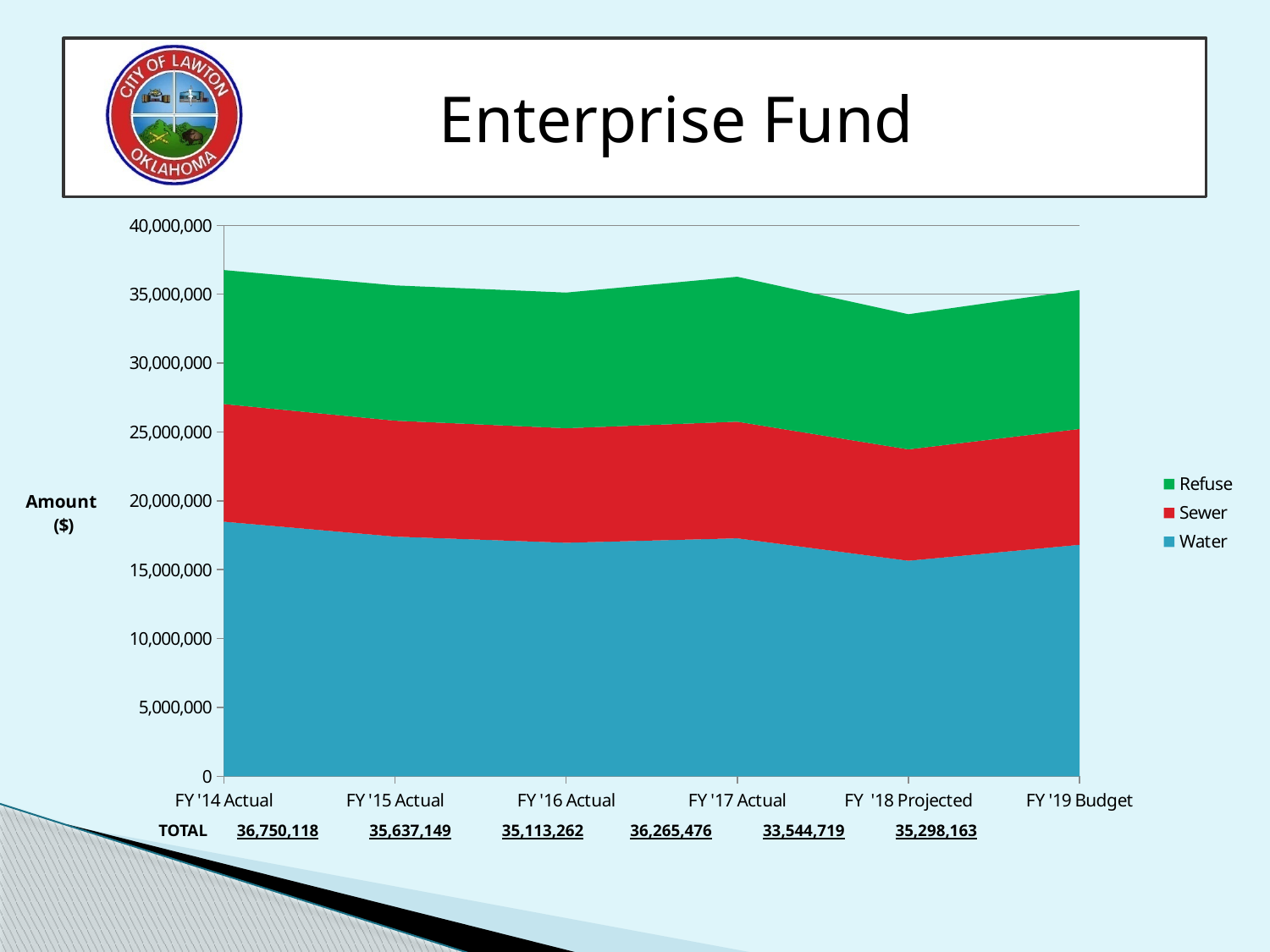
What kind of chart is shown on the slide? Stacked area chart What is the TOTAL shown for FY '14 Actual? 36,750,118 What is the difference between the TOTAL for FY '14 Actual and the TOTAL for FY '18 Projected? 3,205,399 What is the TOTAL shown for FY '18 Projected? 33,544,719 Which is larger, the TOTAL for FY '16 Actual or the TOTAL for FY '17 Actual? FY '17 Actual How many series does the legend list? 3 Do the TOTAL values rise or fall from FY '14 Actual to FY '16 Actual? Fall What is the TOTAL shown for FY '19 Budget? 35,298,163 Is the Water value for FY '14 Actual greater or less than 15,000,000? greater Which fiscal year has the highest TOTAL? FY '14 Actual How many fiscal year categories are shown on the x axis? 6 Which fiscal year has the lowest TOTAL? FY '18 Projected